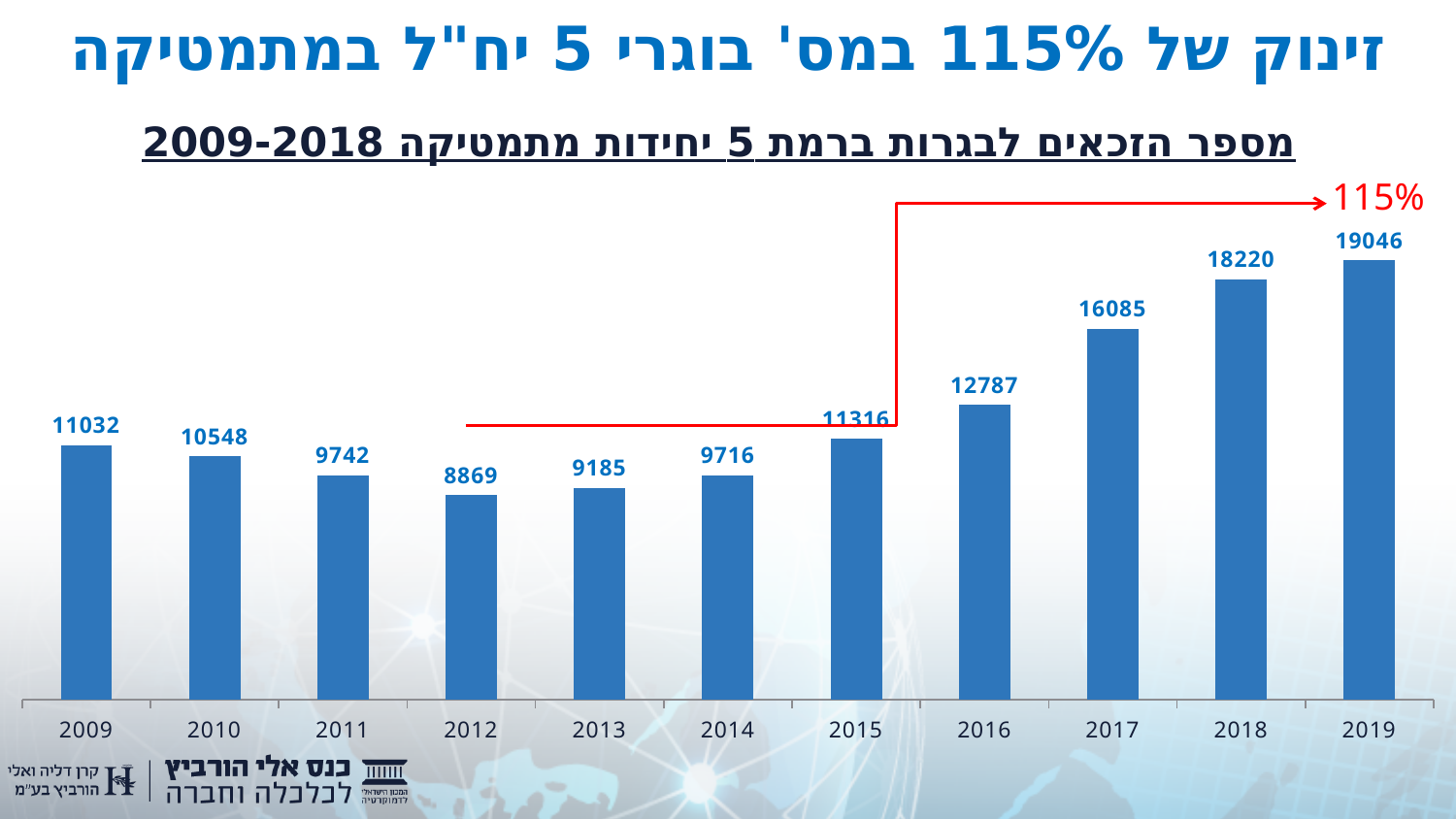
What is the value for 2017? 16085 What is the value for 2009? 11032 How many years are shown on the x axis? 11 Which year has the lowest value? 2012 Which year has the highest value? 2019 What kind of chart is shown on the slide? bar chart What percentage is written in red at the top right of the chart? 115% What is the value for 2012? 8869 Which is larger, the value for 2009 or the value for 2014? 2009 Do the values rise or fall from 2012 to 2019? rise What is the difference between the values for 2016 and 2015? 1471 What is the difference between the values for 2019 and 2018? 826